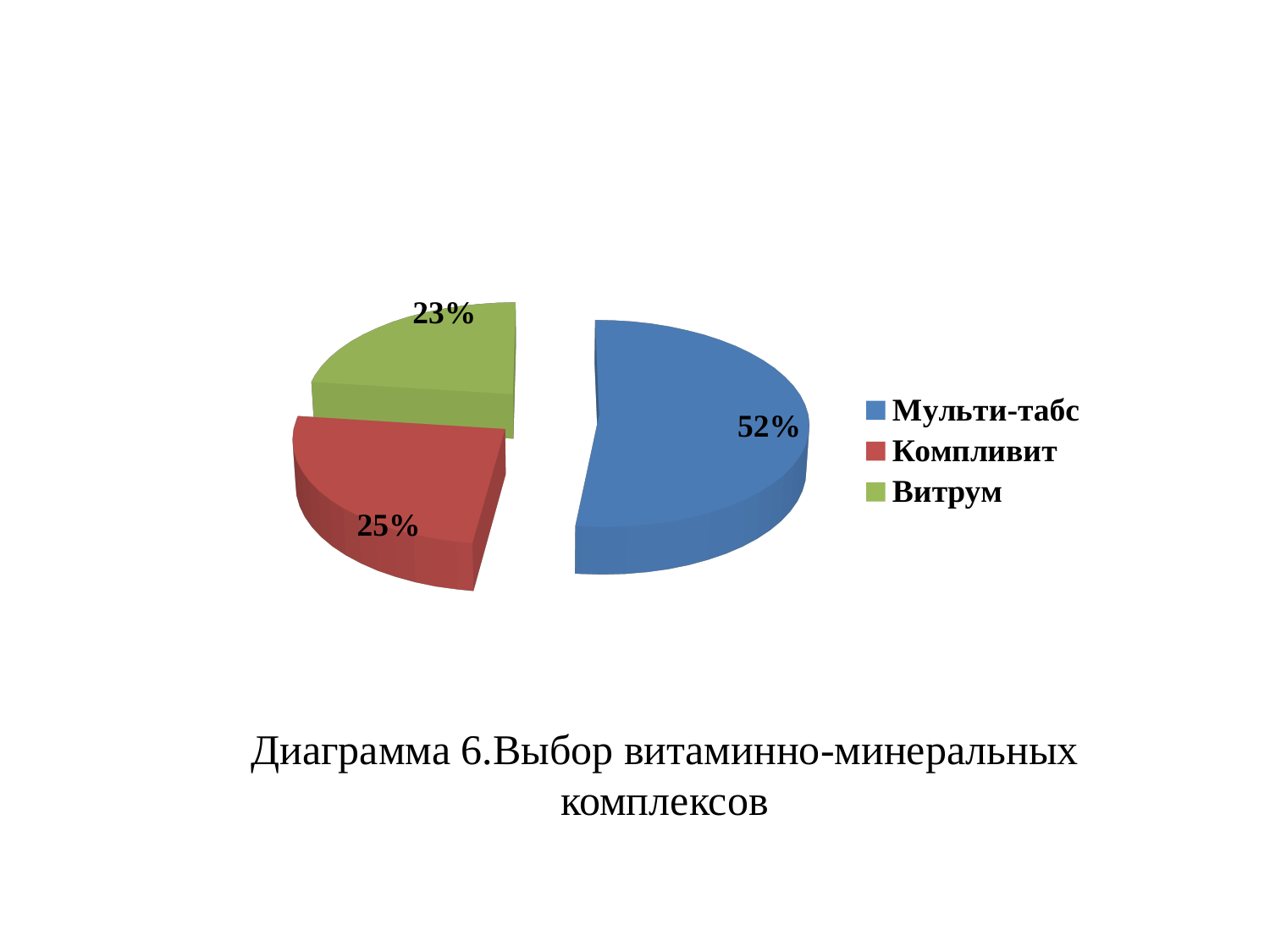
What is the difference between the shares of Мульти-табс and Компливит? 27% What is the caption below the chart? Диаграмма 6.Выбор витаминно-минеральных комплексов How many categories does the pie chart show? 3 What colour is the slice for Компливит? Red What is the difference between the shares of Компливит and Витрум? 2% What share of the pie does Витрум have? 23% Which is larger, the share of Мульти-табс or the share of Витрум? Мульти-табс Which category has the largest slice of the pie? Мульти-табс What kind of chart is shown on the slide? Pie chart What share of the pie does Мульти-табс have? 52% Which category has the smallest slice of the pie? Витрум What share of the pie does Компливит have? 25%